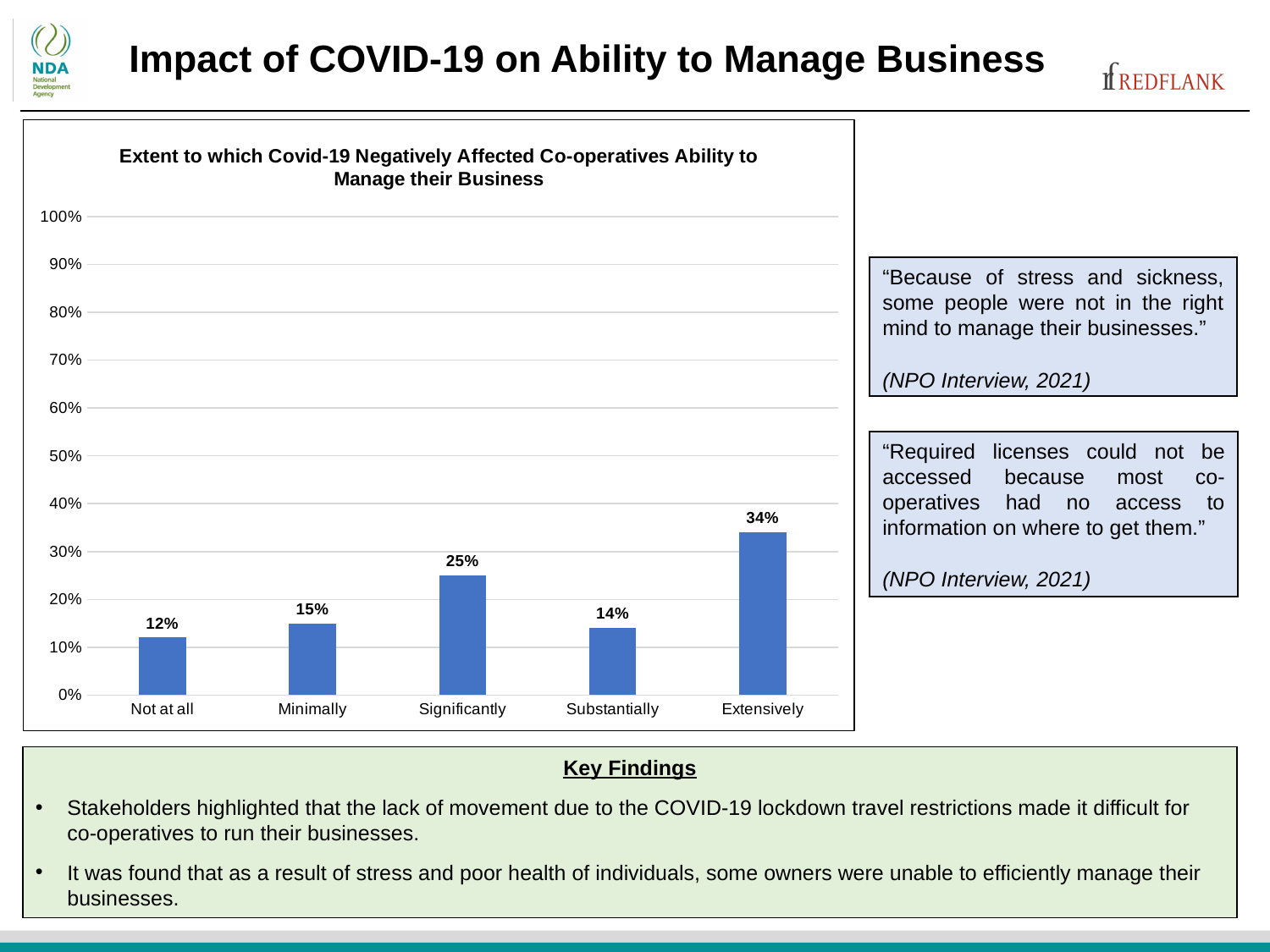
Which category has the highest value in the chart? Extensively What is the value shown for the 'Not at all' category? 12% What kind of chart is shown on the slide? Bar chart Which is larger, the value for 'Significantly' or the value for 'Substantially'? Significantly What is the value shown for the 'Significantly' category? 25% What is the title of the chart? Extent to which Covid-19 Negatively Affected Co-operatives Ability to Manage their Business What percentage of co-operatives reported that Covid-19 affected their ability to manage their business 'Extensively'? 34% What is the difference between the 'Extensively' and 'Significantly' values? 9% How many categories are shown on the x axis of the chart? 5 Is the value for 'Extensively' greater or less than 30%? greater What is the difference between the 'Minimally' and 'Substantially' values? 1% Which category has the lowest value in the chart? Not at all